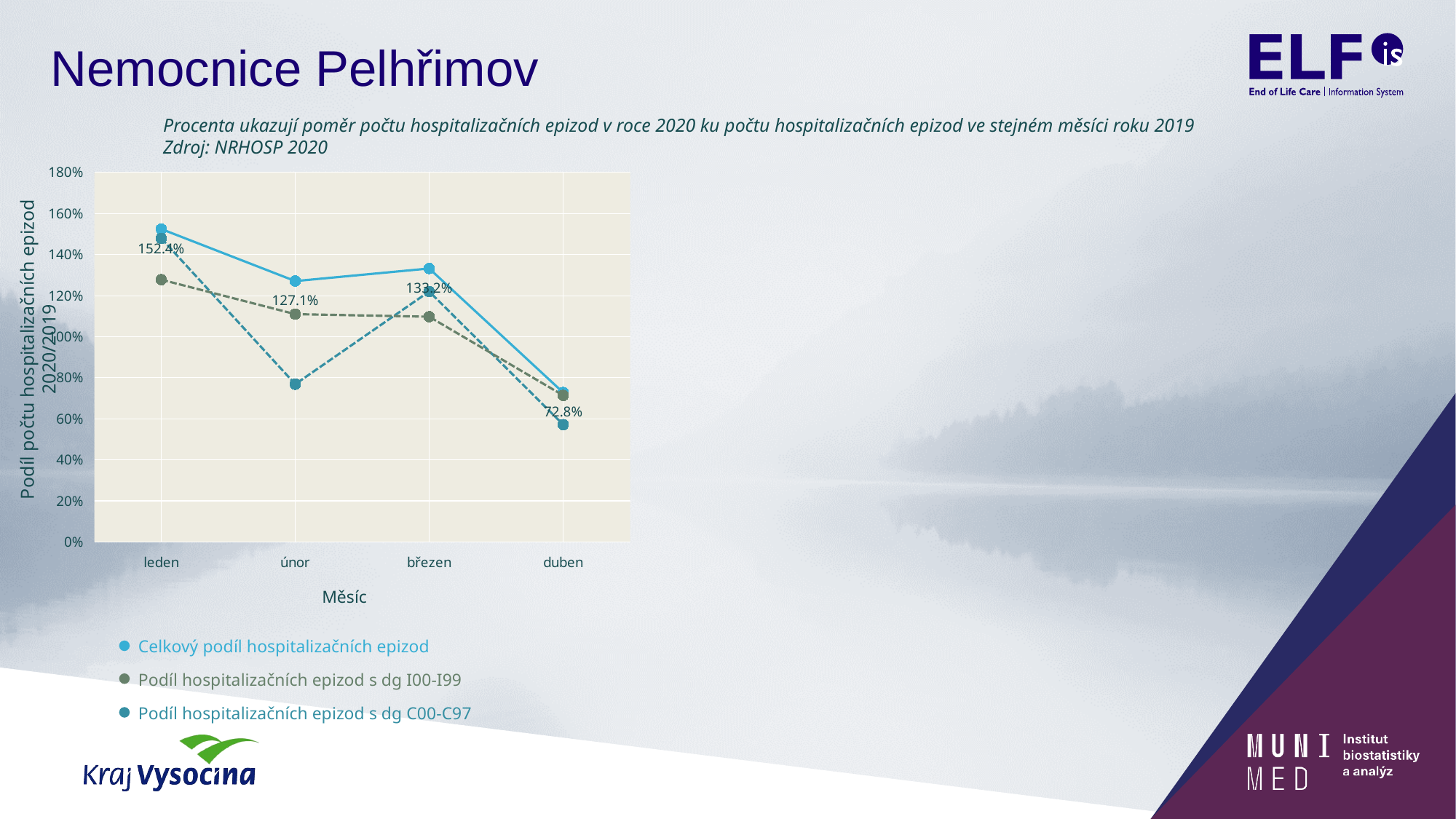
What is the value of Celkový podíl hospitalizačních epizod for duben? 72.8% For Celkový podíl hospitalizačních epizod, which is larger: únor or březen? březen Is the value of Podíl hospitalizačních epizod s dg I00-I99 for leden greater or less than 120%? greater What kind of chart is shown on the slide? line chart In which month is Celkový podíl hospitalizačních epizod lowest? duben What is the difference between the Celkový podíl hospitalizačních epizod values for leden and duben? 79.6 percentage points How many months are shown on the x axis? 4 In which month is Celkový podíl hospitalizačních epizod highest? leden Is the value of Podíl hospitalizačních epizod s dg C00-C97 for únor greater or less than 80%? less What is the value of Celkový podíl hospitalizačních epizod for březen? 133.2% What is the value of Celkový podíl hospitalizačních epizod for leden? 152.4% How many series does the legend list? 3